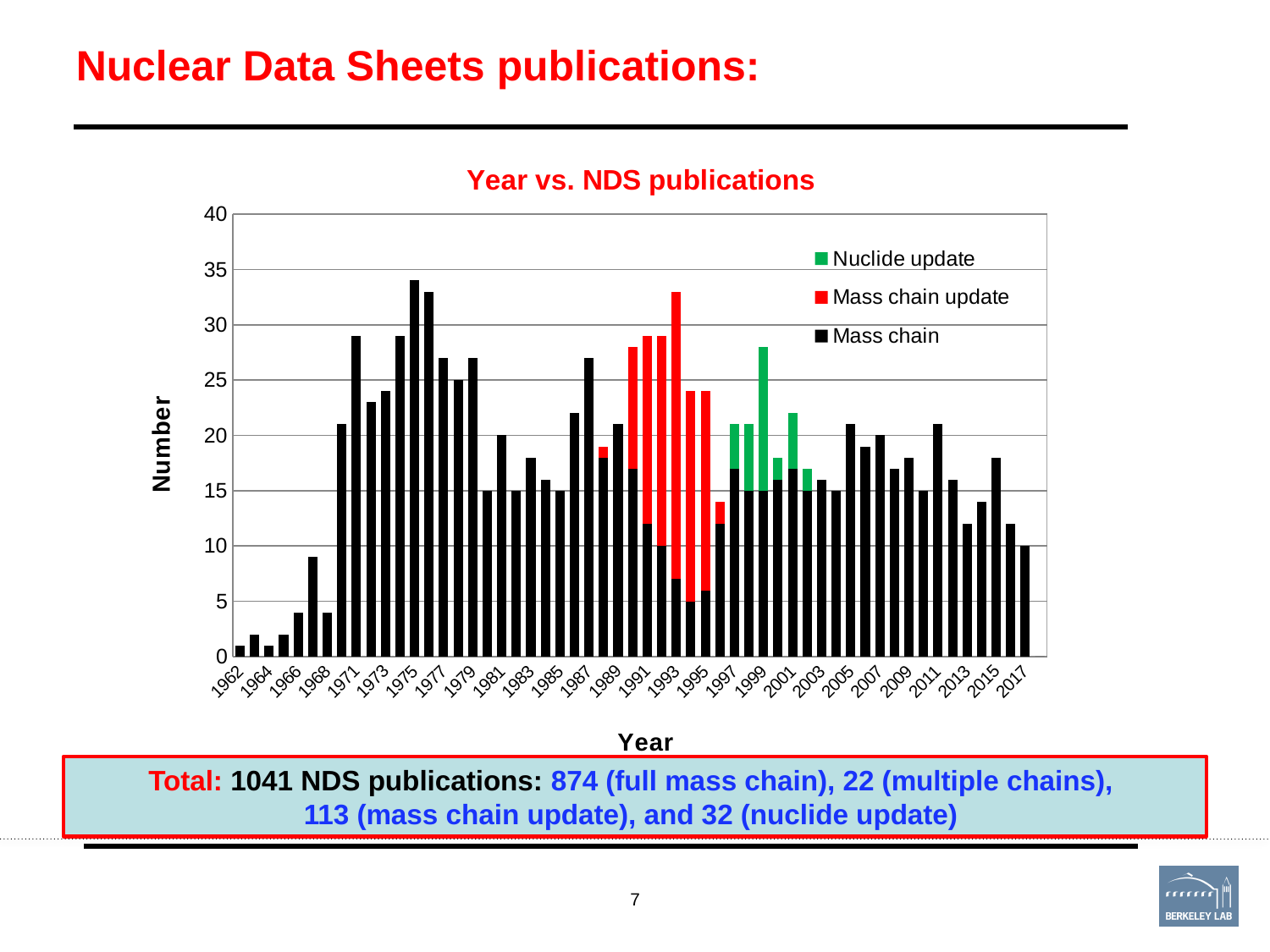
How many series does the legend list? 3 Is the value for 2017 greater or less than 15? less Which year has the larger value, 1975 or 1962? 1975 What kind of chart is shown on the slide? bar chart What is the title of the chart? Year vs. NDS publications Which series is shown in green in the legend? Nuclide update Is the value for 1981 greater or less than 15? greater Which year has the larger value, 1971 or 1981? 1971 Is the value for 1962 greater or less than 5? less Do the values generally rise or fall from 1962 to 1971? rise